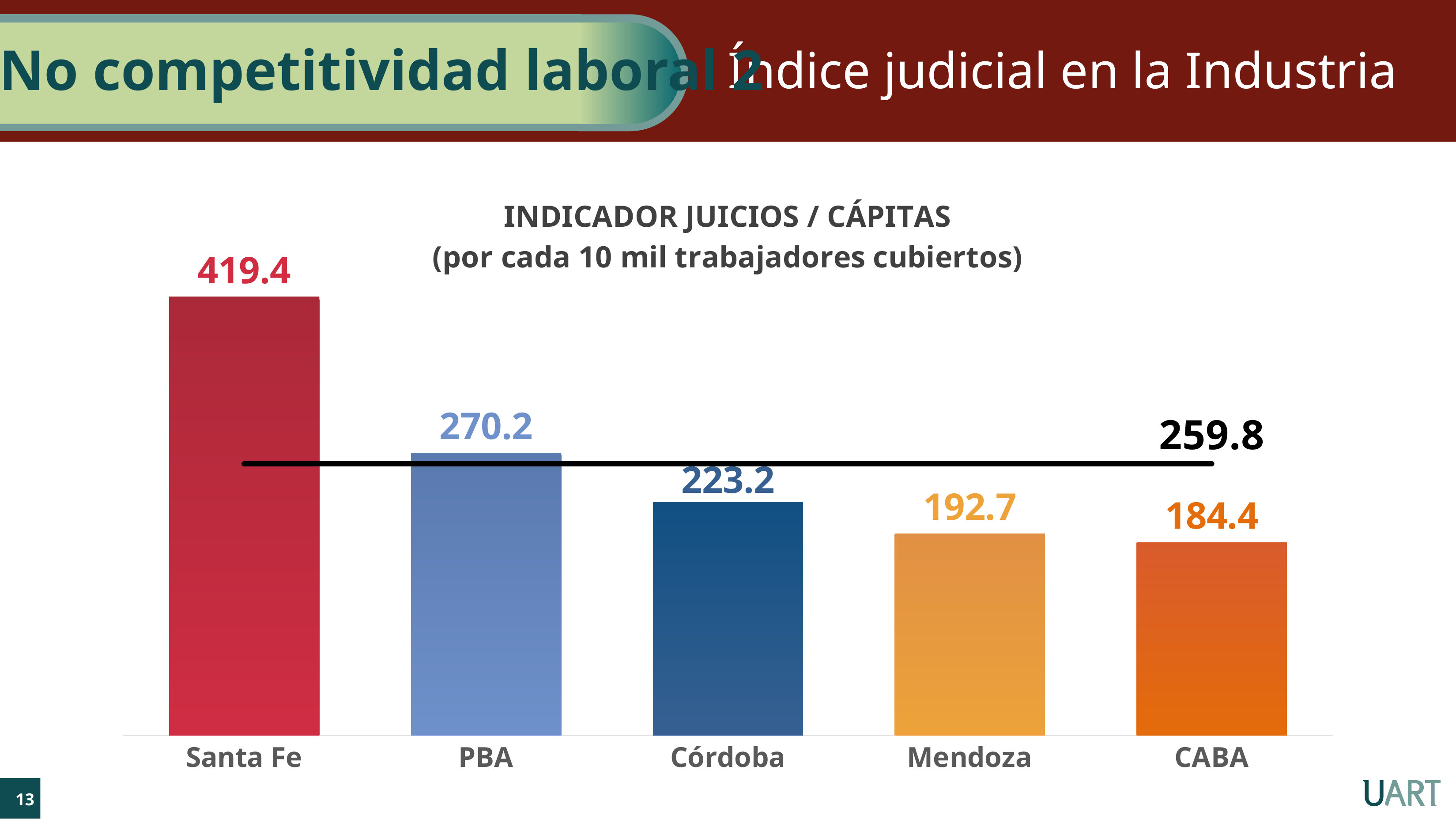
Which is larger, the value for Córdoba or the value for Mendoza? Córdoba How many categories are shown on the x axis? 5 What is the value for PBA? 270.2 What is the value for Mendoza? 192.7 Which category has the highest value? Santa Fe What is the value for Córdoba? 223.2 What is the difference between the values for Santa Fe and PBA? 149.2 Which category has the lowest value? CABA What value is labelled on the horizontal reference line drawn across the chart? 259.8 What is the value for Santa Fe? 419.4 What is the value for CABA? 184.4 What kind of chart is shown on the slide? Bar chart